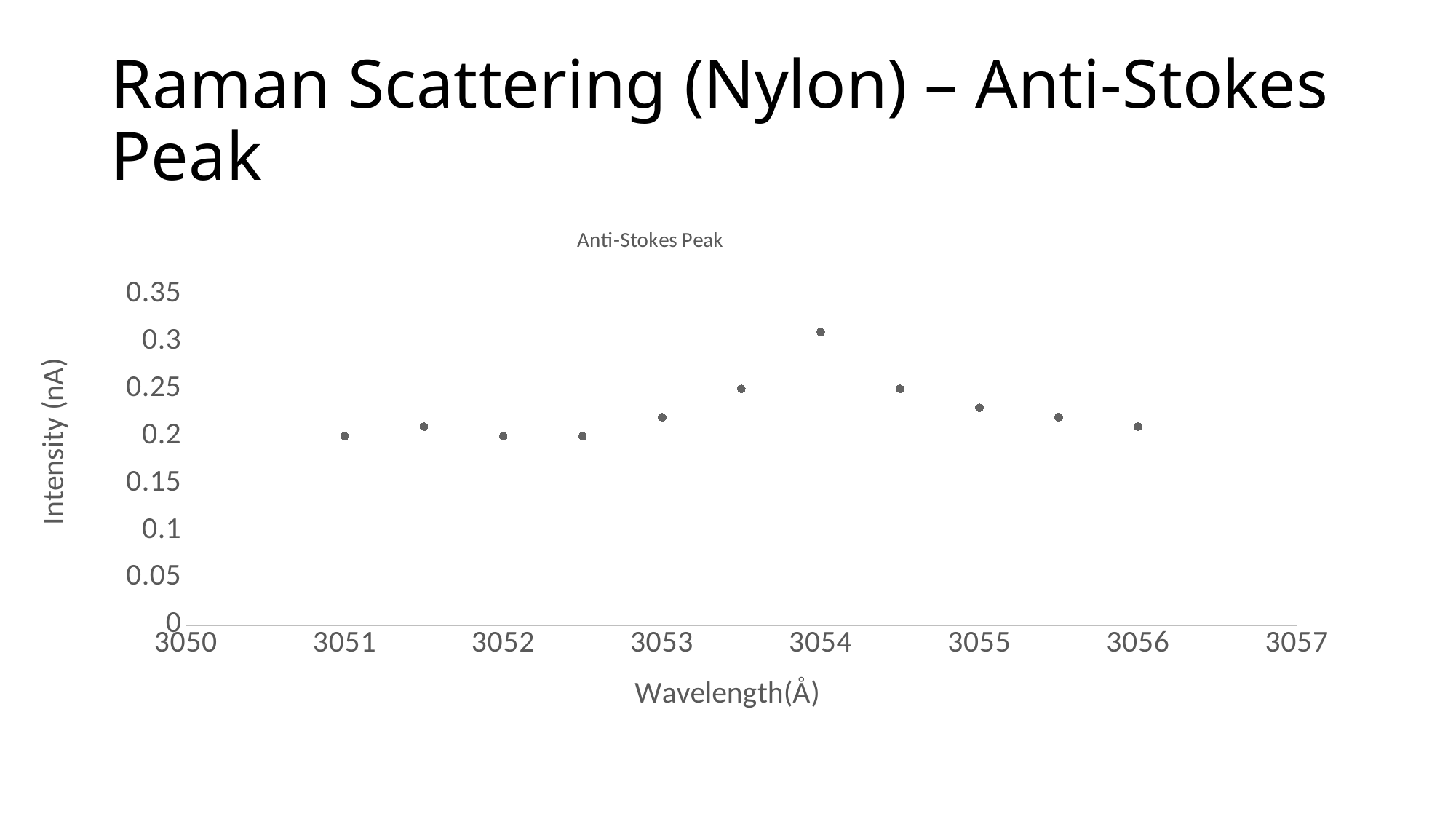
How many data points are plotted on the chart? 11 What kind of chart is shown on the slide? scatter chart Is the intensity at wavelength 3051 greater or less than 0.25? less Which has the higher intensity, wavelength 3054 or wavelength 3051? 3054 What is the label of the y axis? Intensity (nA) Is the intensity at wavelength 3054 greater or less than 0.3? greater Is the intensity at wavelength 3055 greater or less than 0.15? greater What is the title of the chart? Anti-Stokes Peak Which has the higher intensity, wavelength 3053.5 or wavelength 3052? 3053.5 Do the intensity values rise or fall between wavelength 3054 and wavelength 3056? fall At which wavelength is the intensity highest? 3054